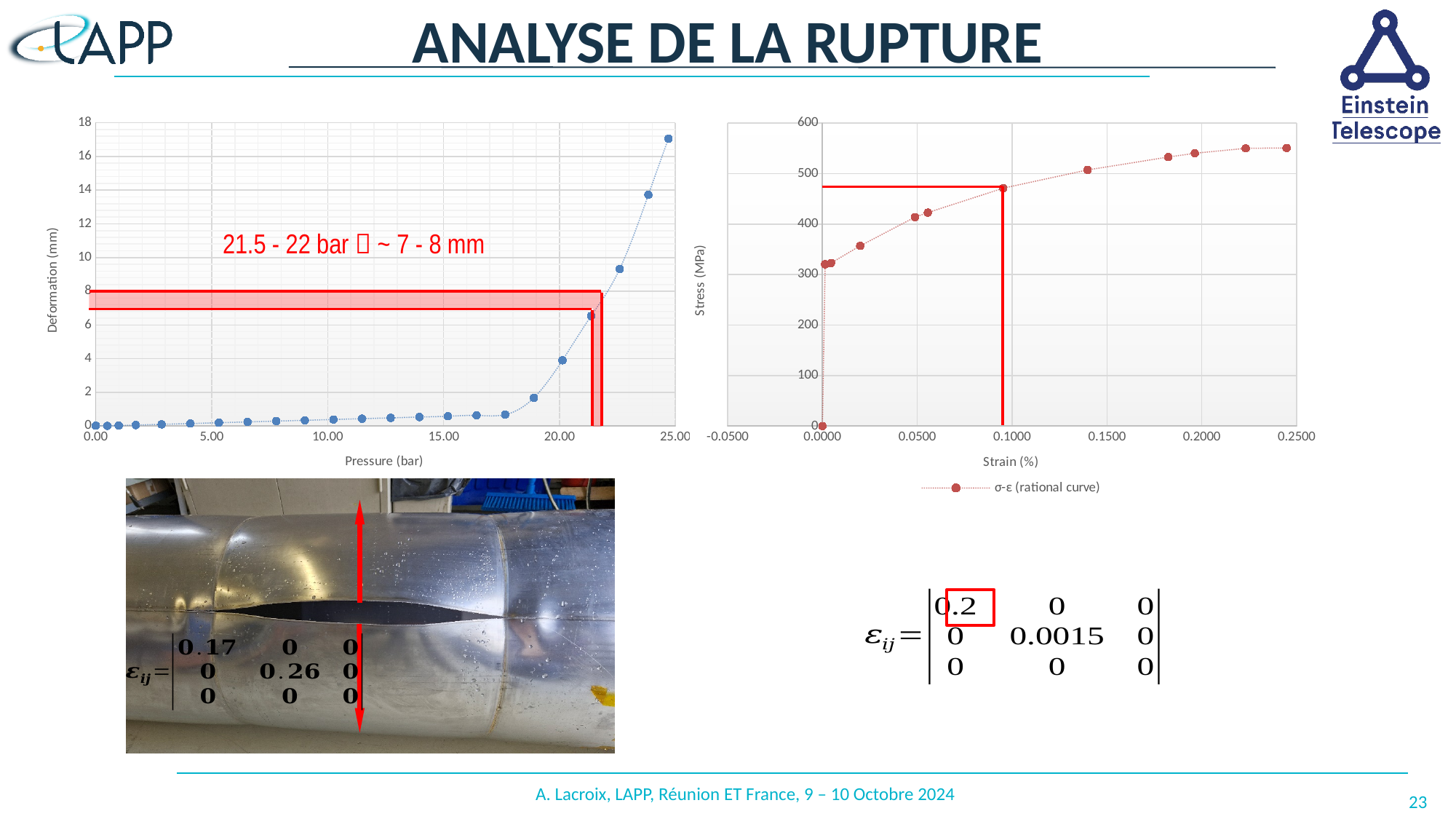
In the left chart, which is larger: the deformation at 20 bar or at 10 bar? at 20 bar In the left chart, is the deformation at 10 bar greater or less than 2 mm? less In the left chart, does deformation rise or fall as pressure increases? rise What kind of chart is the right chart (Stress vs Strain)? scatter chart with dotted line In the right chart, is the stress at a strain of 0.0500% greater or less than 500 MPa? less In the right chart, is the stress at a strain of 0.2500% greater or less than 500 MPa? greater What kind of chart is the left chart (Deformation vs Pressure)? scatter chart with dotted line In the right chart, does stress rise or fall as strain increases? rise In the left chart, what is the label of the x axis? Pressure (bar) In the right chart, what series does the legend list? σ-ε (rational curve) How many series does the legend of the right chart list? 1